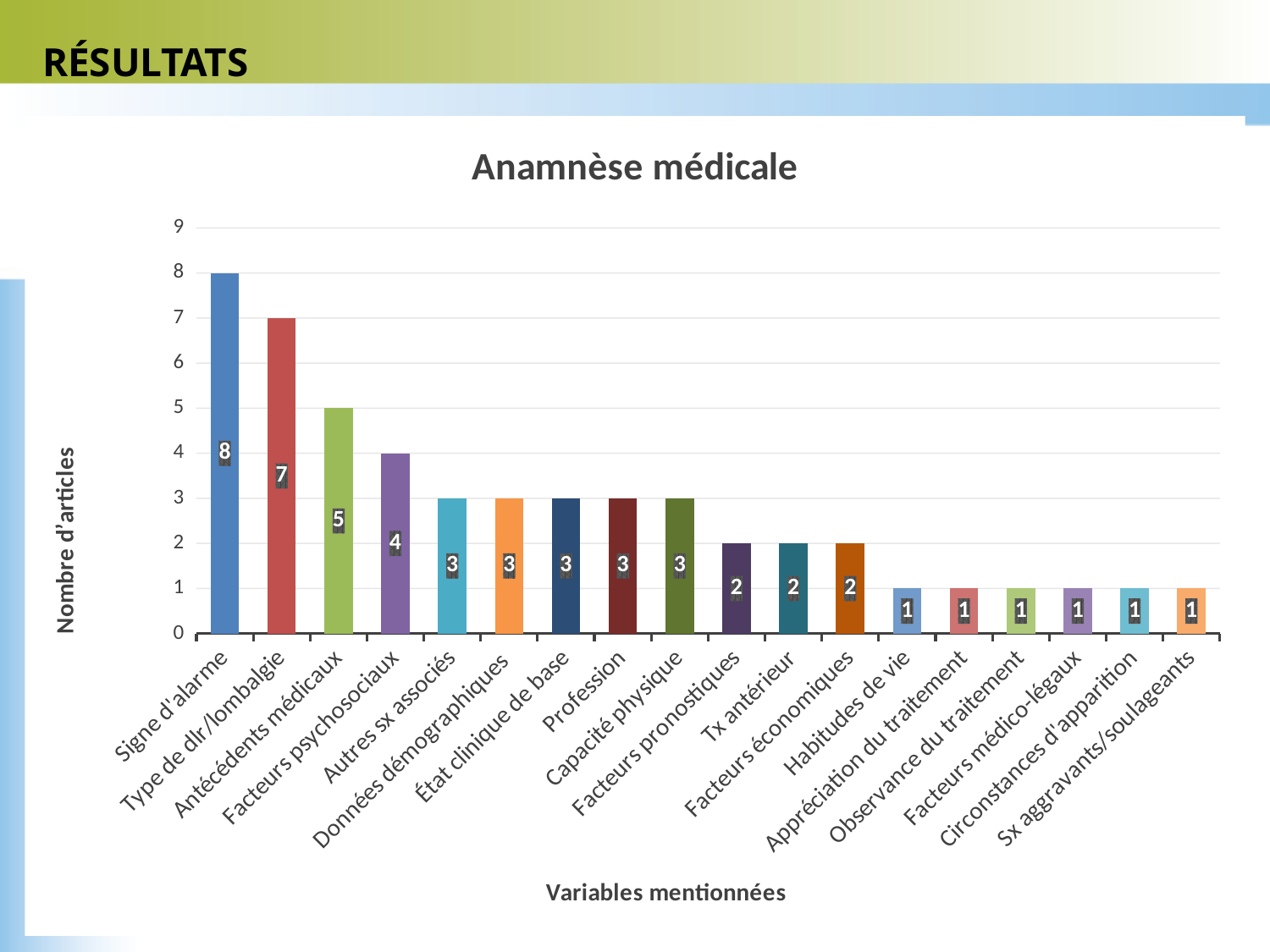
What is the value for Tx antérieur? 2 What is the value for Signe d'alarme? 8 Do the values rise or fall from left to right along the x axis? Fall What is the value for Facteurs psychosociaux? 4 What kind of chart is this? Bar chart What is the difference between Signe d'alarme and Type de dlr/lombalgie? 1 What is the value for Antécédents médicaux? 5 Which category has the highest value? Signe d'alarme Which is larger, Facteurs psychosociaux or Profession? Facteurs psychosociaux How many categories are shown on the x axis? 18 What is the difference between Antécédents médicaux and Habitudes de vie? 4 What is the title of the chart? Anamnèse médicale